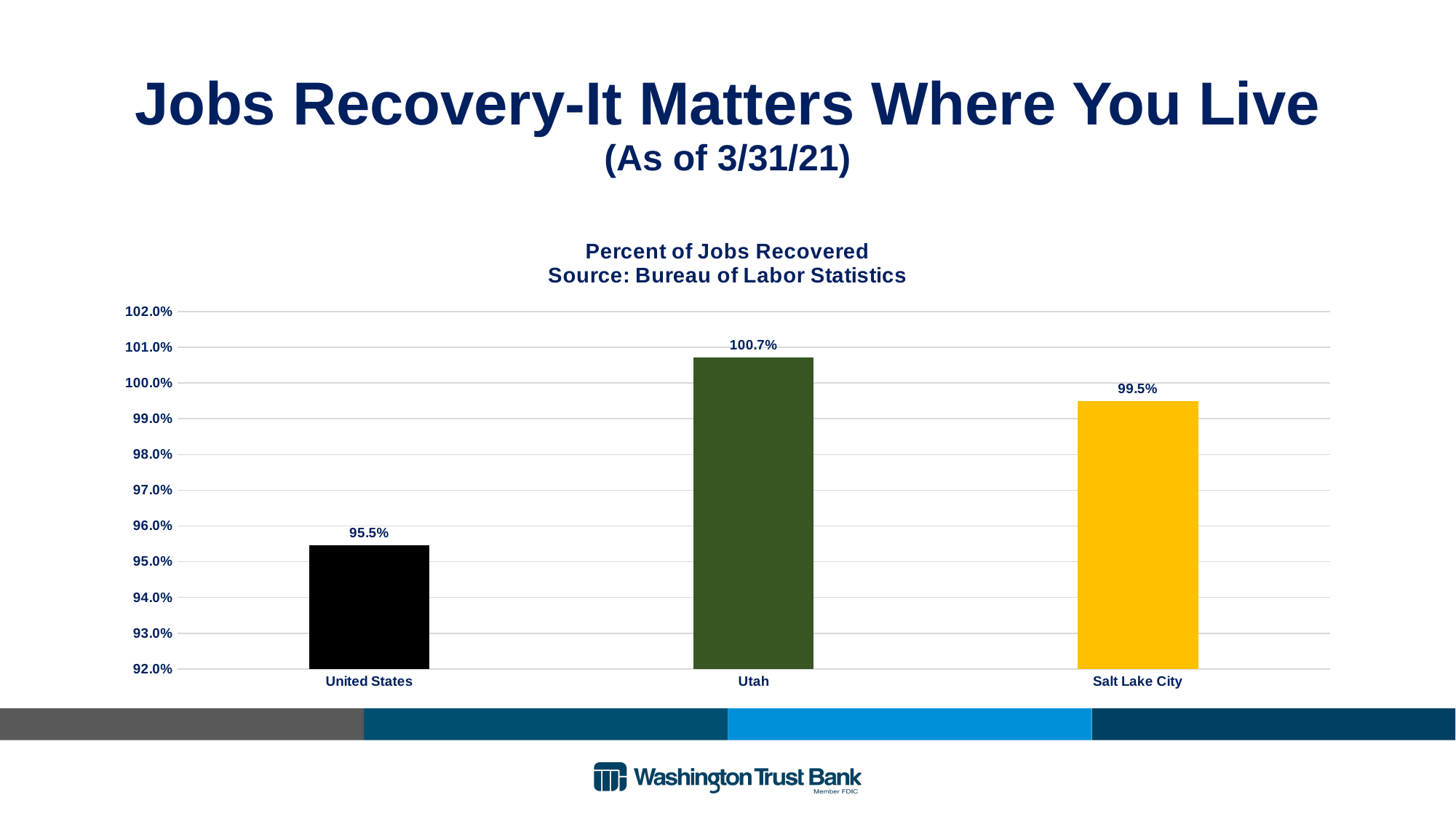
What source is cited in the chart title? Bureau of Labor Statistics What is the difference in percent of jobs recovered between Utah and Salt Lake City? 1.2% Is the value for Utah greater or less than 100.0%? greater What is the percent of jobs recovered for Utah? 100.7% Which category has the highest percent of jobs recovered? Utah What kind of chart is shown on the slide? Bar chart Which category has the lowest percent of jobs recovered? United States Which has a higher percent of jobs recovered, Salt Lake City or the United States? Salt Lake City What is the difference in percent of jobs recovered between Utah and the United States? 5.2% What is the percent of jobs recovered for the United States? 95.5% How many categories are shown in the chart? 3 What is the percent of jobs recovered for Salt Lake City? 99.5%